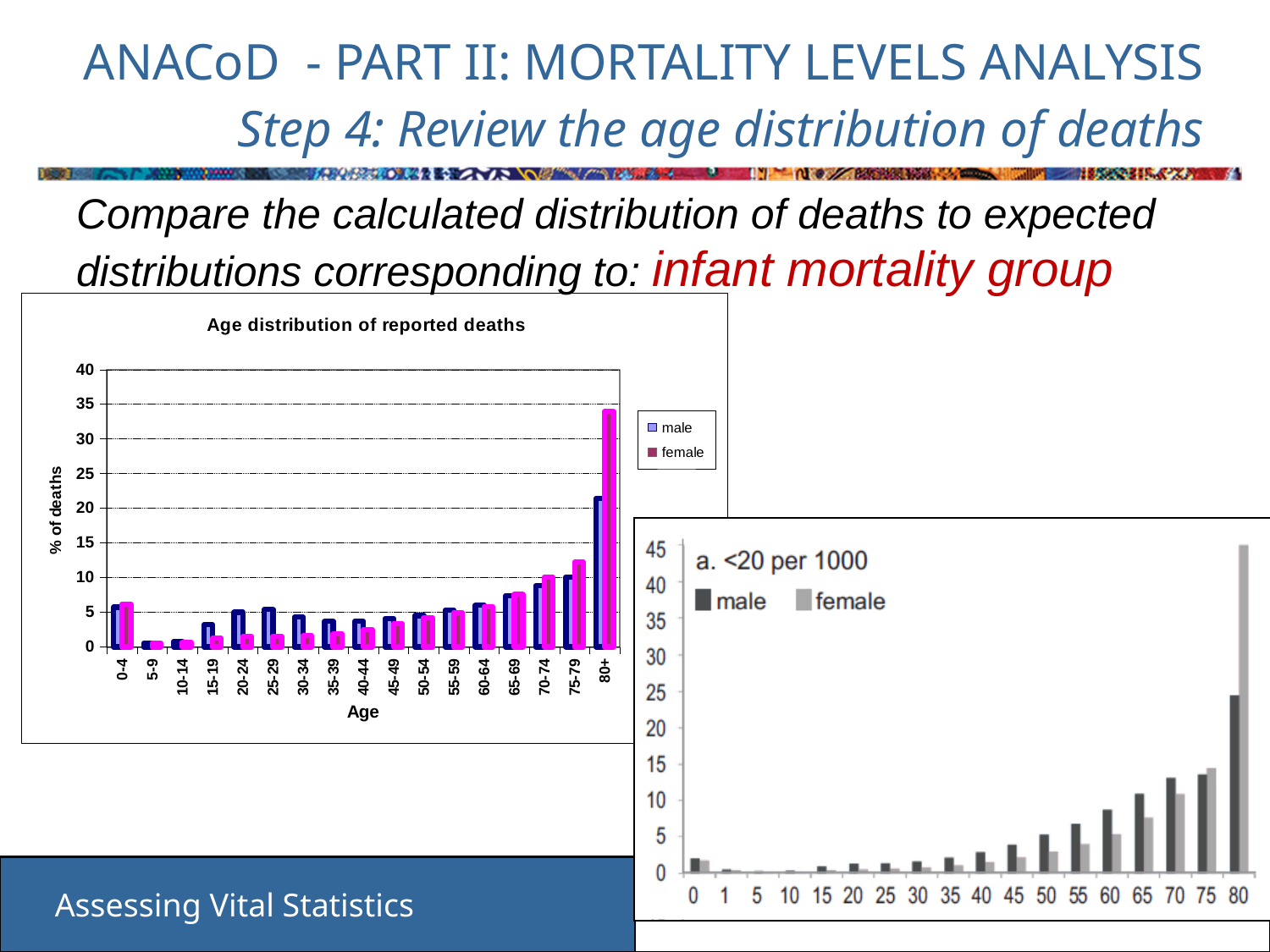
In the 'Age distribution of reported deaths' chart, which age group has the highest % of deaths for females? 80+ In the 'Age distribution of reported deaths' chart, how many series does the legend list? 2 In the 'Age distribution of reported deaths' chart, which is larger for the 80+ group, male or female? female In the 'Age distribution of reported deaths' chart, how many age groups are shown on the x axis? 17 In the 'Age distribution of reported deaths' chart, is the male value for 80+ greater or less than 25? less What is the title of the chart on the right side of the slide? a. <20 per 1000 In the 'Age distribution of reported deaths' chart, is the female value for 80+ greater or less than 30? greater What kind of chart is the 'Age distribution of reported deaths' chart? bar chart In the 'a. <20 per 1000' chart, which series has the highest bar at age 80? female In the 'a. <20 per 1000' chart, is the female value at age 80 greater or less than 40? greater In the 'Age distribution of reported deaths' chart, do the values rise or fall from the 40-44 group to the 80+ group? rise In the 'Age distribution of reported deaths' chart, which is larger for males, the 0-4 group or the 5-9 group? 0-4